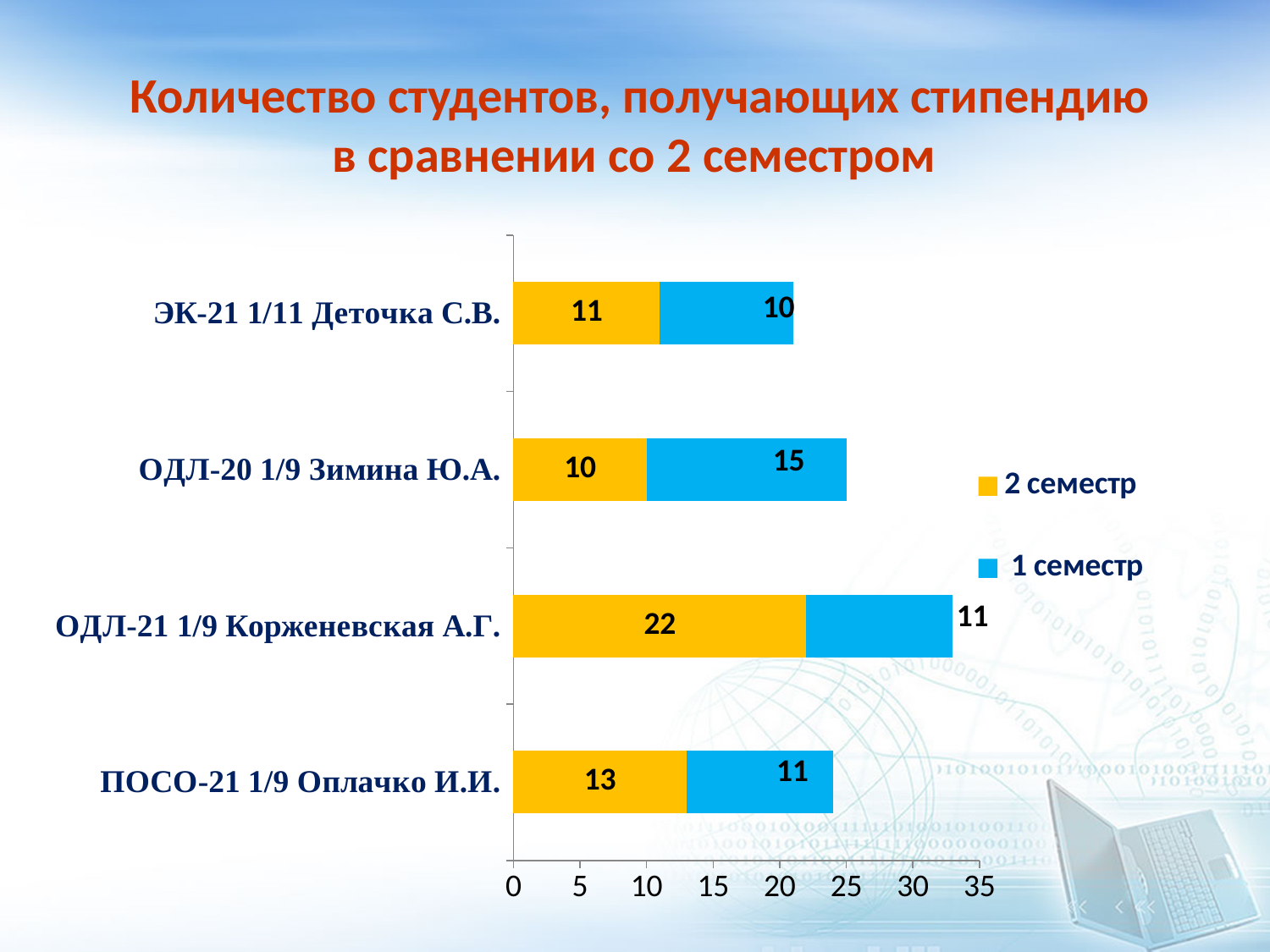
What is the total of the stacked bar for ОДЛ-21 1/9 Корженевская А.Г.? 33 Which category has the lowest value for "1 семестр"? ЭК-21 1/11 Деточка С.В. How many series does the legend list? 2 How many categories (groups) are shown on the chart? 4 What is the value of "1 семестр" for ОДЛ-20 1/9 Зимина Ю.А.? 15 What is the value of "2 семестр" for ПОСО-21 1/9 Оплачко И.И.? 13 Which is larger for ЭК-21 1/11 Деточка С.В.: the "2 семестр" value or the "1 семестр" value? 2 семестр What is the difference between the "2 семестр" and "1 семестр" values for ОДЛ-20 1/9 Зимина Ю.А.? 5 What type of chart is shown on the slide? Stacked bar chart Which series is shown in yellow in the legend? 2 семестр Which category has the highest value for "2 семестр"? ОДЛ-21 1/9 Корженевская А.Г. What is the value of "2 семестр" for ОДЛ-21 1/9 Корженевская А.Г.? 22